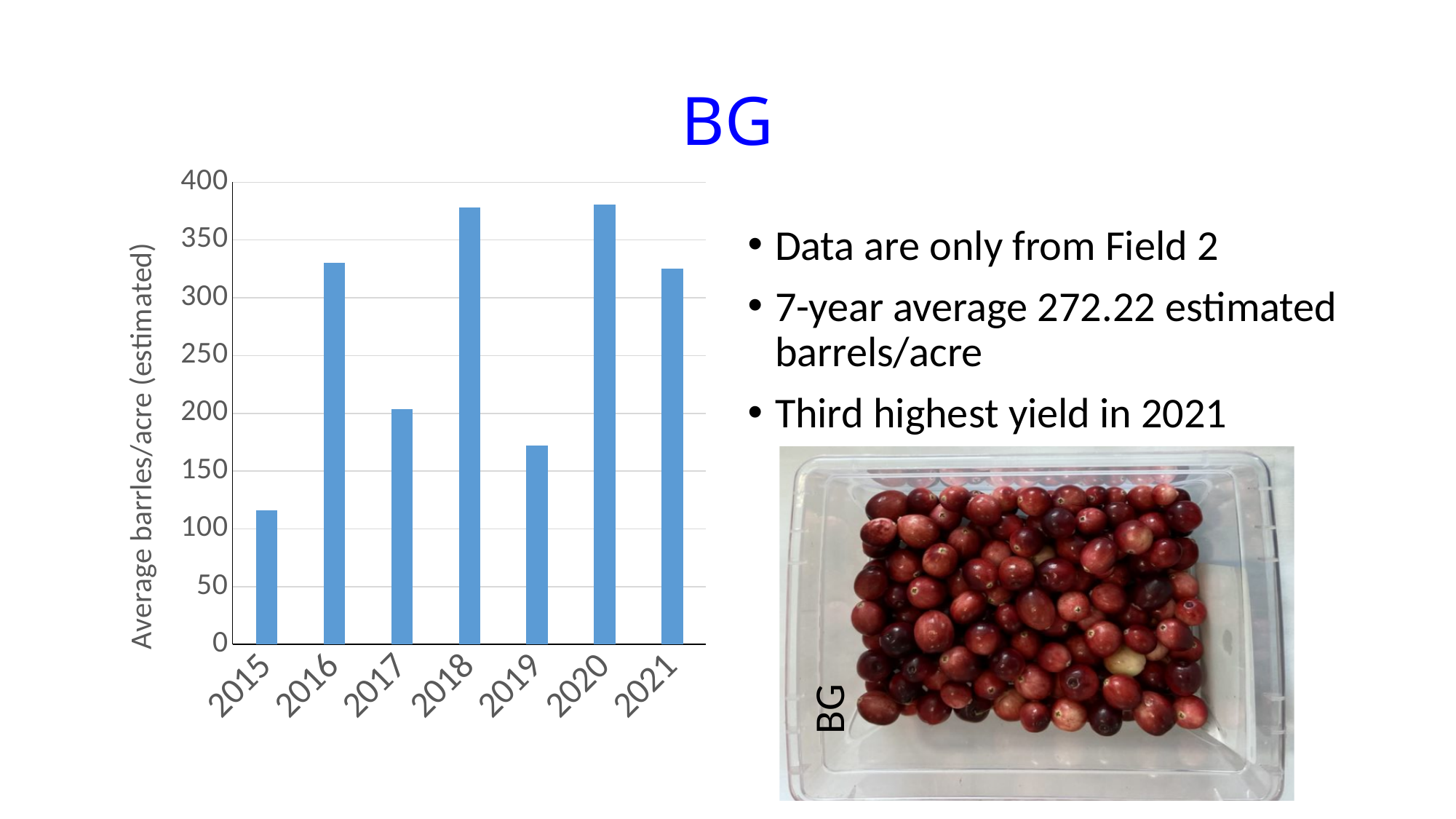
Which is larger, the value for 2019 or the value for 2021? 2021 Does the value rise or fall from 2015 to 2016? rise Is the value for 2015 greater or less than 150? less Is the value for 2017 greater or less than 250? less Is the value for 2019 greater or less than 200? less What kind of chart is shown on the slide? bar chart Which is larger, the value for 2016 or the value for 2017? 2016 What is the label on the vertical axis of the chart? Average barrels/acre (estimated) How many years are plotted on the chart? 7 Which year has the lowest average barrels/acre? 2015